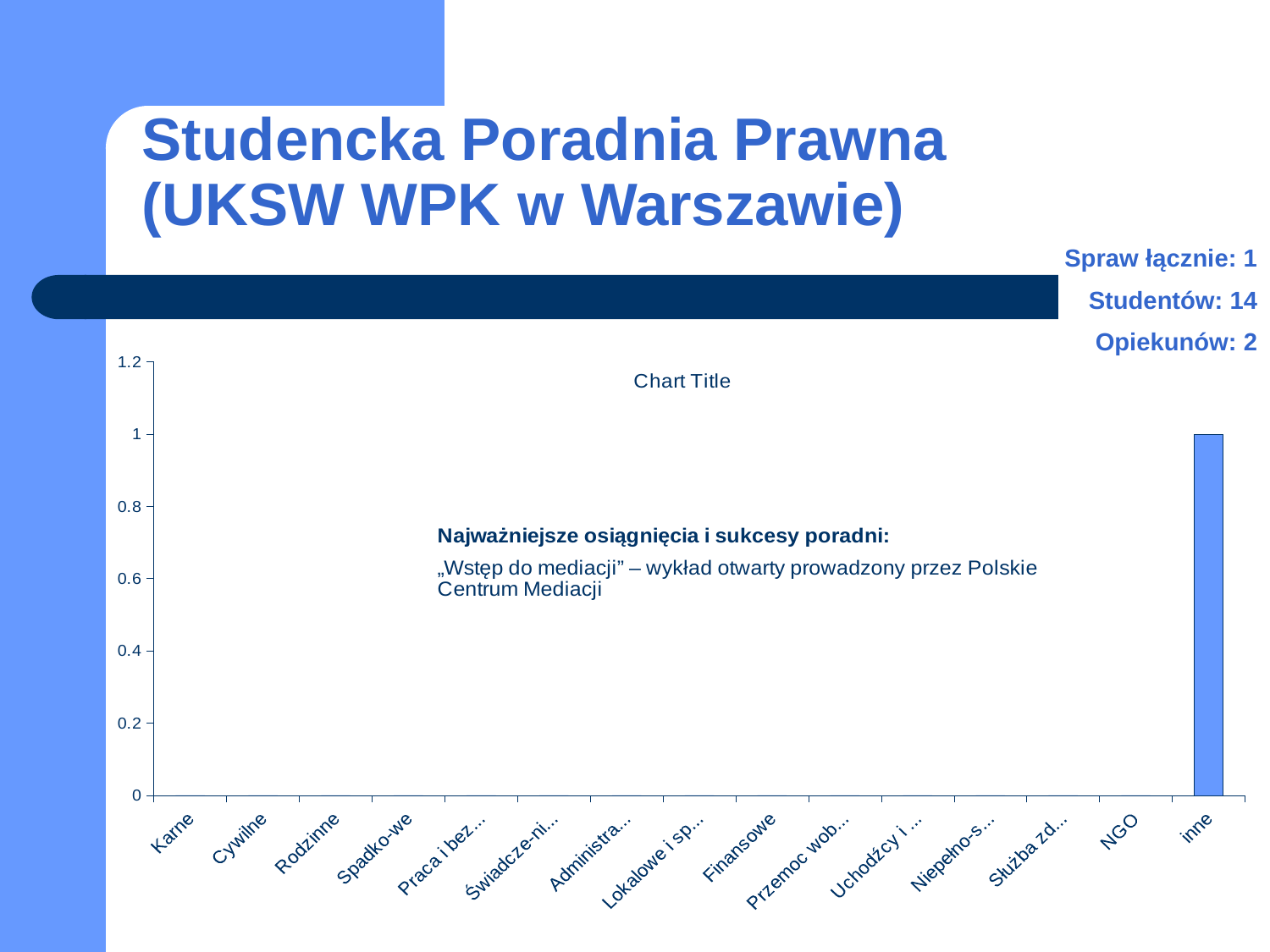
Which category has the highest value in the chart? inne Is the value for "inne" greater or less than 0.8? greater What is the highest value shown on the y axis of the chart? 1.2 What is the value for the category "inne"? 1 Which has the larger value, "inne" or "Karne"? inne Which has the larger value, "NGO" or "inne"? inne How many categories are shown on the x axis of the chart? 15 Is the value for "inne" greater or less than 1.2? less What kind of chart is shown on the slide? bar chart What is the title of the chart? Chart Title What is the label of the first category on the x axis? Karne